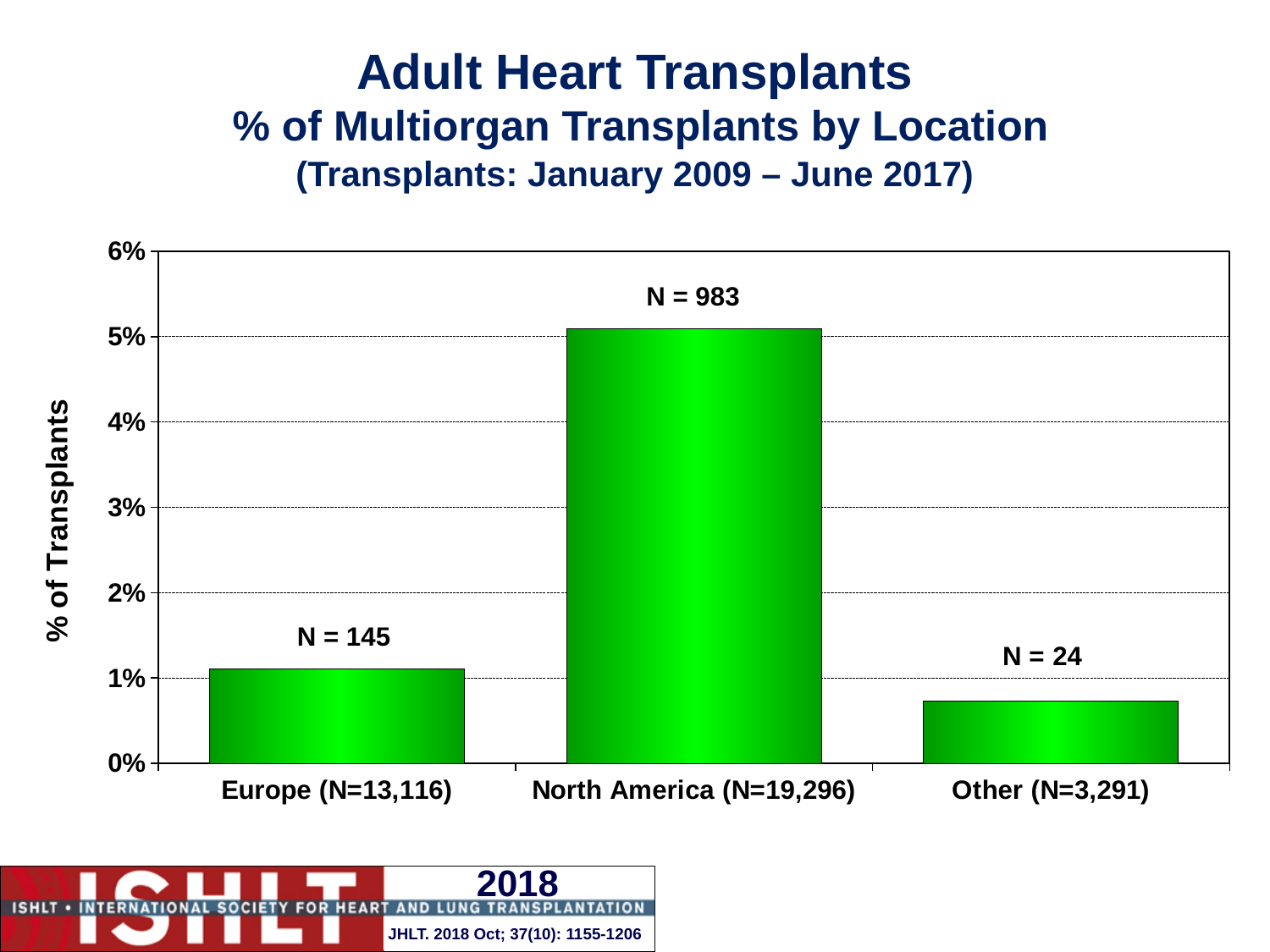
What type of chart is shown on the slide? bar chart What is the label on the vertical axis of the chart? % of Transplants Is the value for North America greater or less than 4%? greater What is the difference between the N labelled above the North America bar and the N labelled above the Europe bar? 838 What is the N value labelled above the Other bar? N = 24 Which location has the highest % of multiorgan transplants? North America Which location has the lowest % of multiorgan transplants? Other What is the N value labelled above the Europe bar? N = 145 Is the value for Other greater or less than 1%? less How many location categories are shown on the chart? 3 Which has a higher % of multiorgan transplants, Europe or Other? Europe What is the N value labelled above the North America bar? N = 983